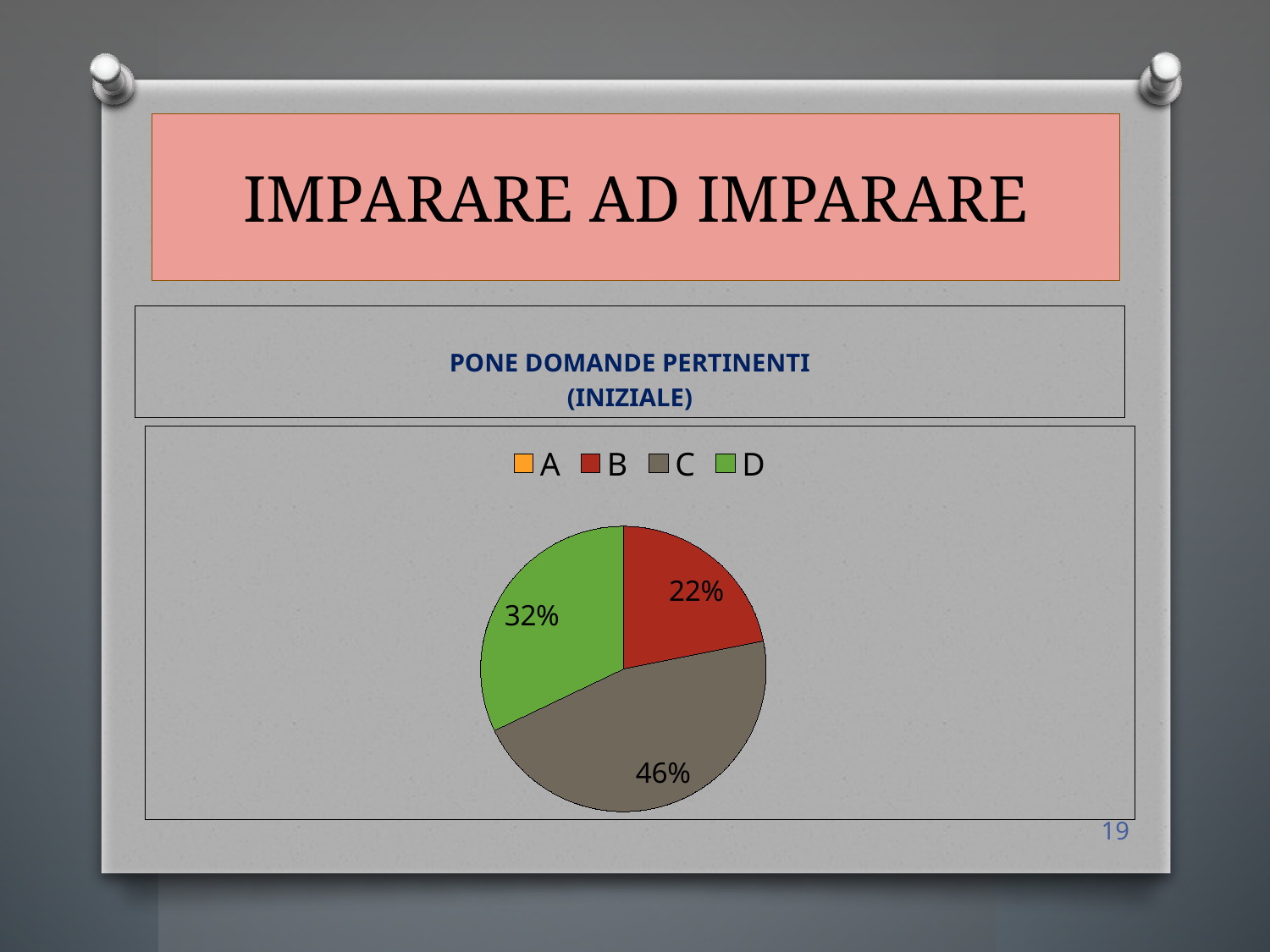
What is the difference in percentage points between slice C and slice B? 24 What colour is used for category D in the pie chart? green What percentage does slice C represent in the pie chart? 46% Which is larger, slice D or slice B? D Which category has the largest slice in the pie chart? C What is the difference in percentage points between slice D and slice B? 10 How many entries does the legend of the pie chart list? 4 What is the title shown above the pie chart? PONE DOMANDE PERTINENTI (INIZIALE) What percentage does slice D represent in the pie chart? 32% What kind of chart is shown on the slide? pie chart What percentage does slice B represent in the pie chart? 22% Of the slices with printed labels, which category has the smallest share? B